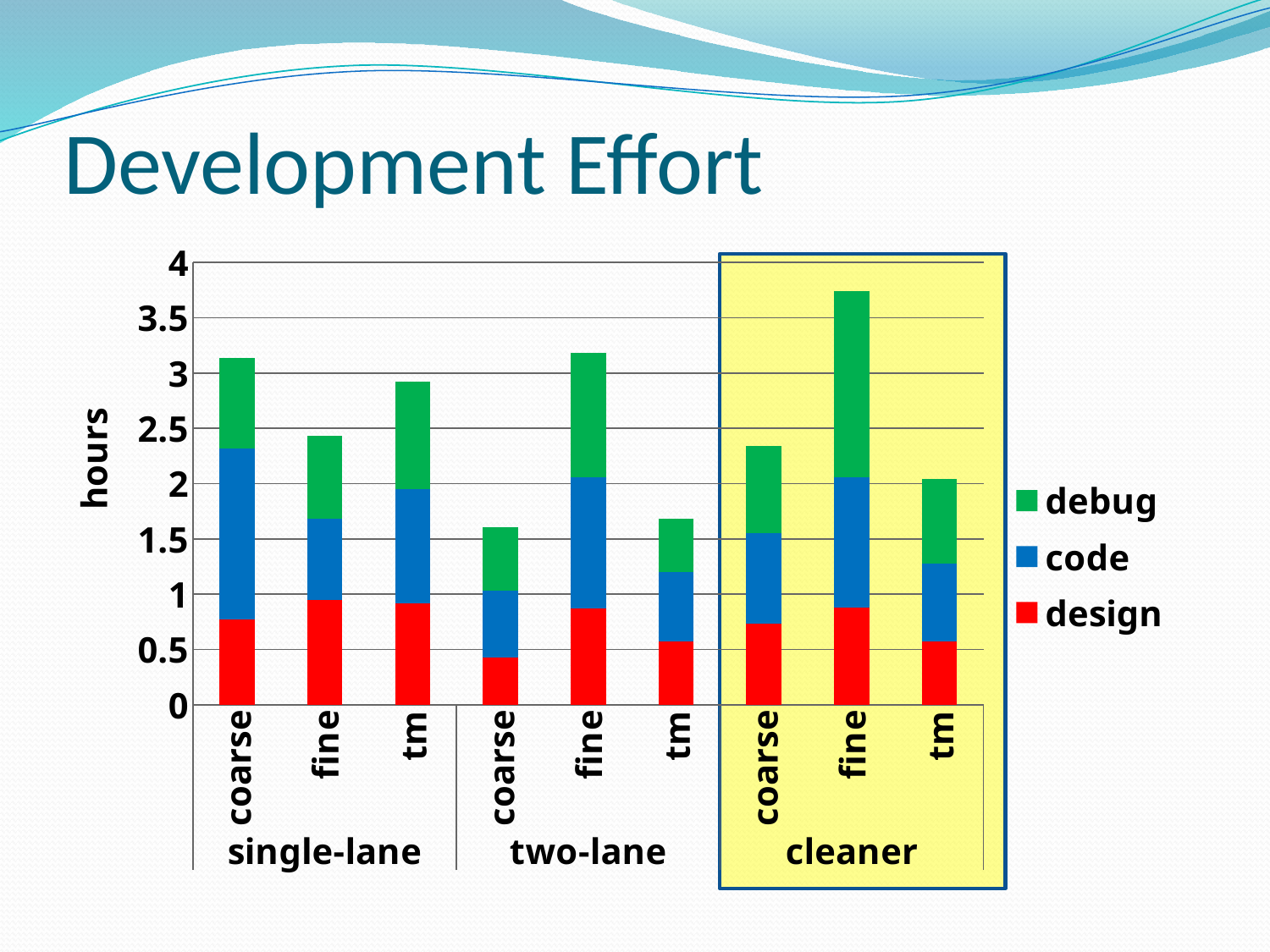
Is the total for the cleaner tm bar greater or less than 2.5? less What is the label on the vertical axis? hours What kind of chart is shown on the slide? stacked bar chart Which has the larger total: two-lane fine or two-lane tm? two-lane fine How many series does the legend list? 3 How many bars are plotted in the chart? 9 Which has the larger total: single-lane coarse or single-lane fine? single-lane coarse Which bar has the highest total hours? cleaner fine Is the total for the single-lane coarse bar greater or less than 3? greater Is the total for the cleaner fine bar greater or less than 3.5? greater Which group of bars is highlighted with a yellow box? cleaner